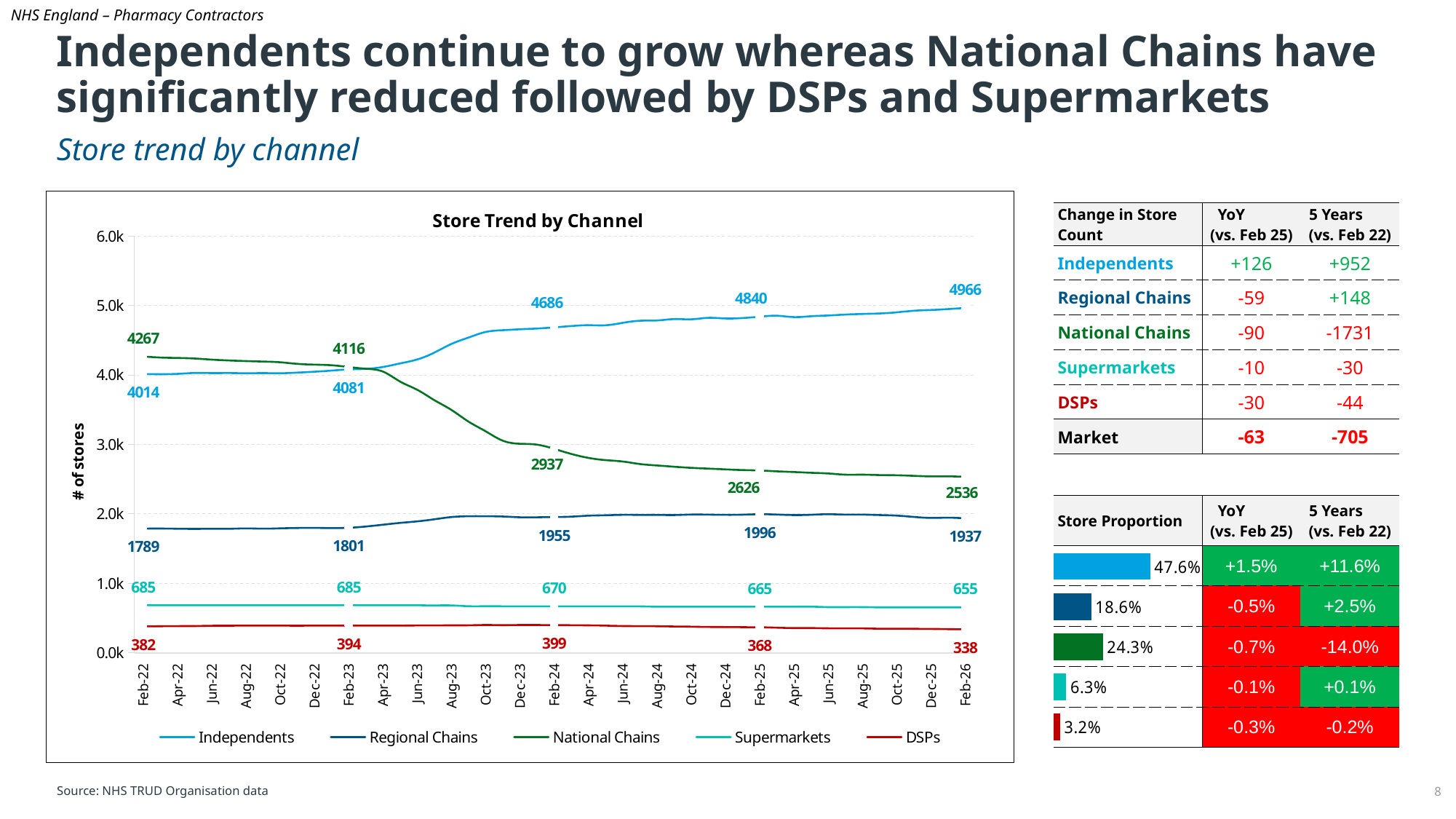
In the 'Store Trend by Channel' chart, what is the label of the y axis? # of stores In the 'Store Trend by Channel' chart, what is the value for Independents at Feb-26? 4966 In the 'Store Trend by Channel' chart, what is the value for DSPs at Feb-22? 382 How many series does the legend of the 'Store Trend by Channel' chart list? 5 In the 'Store Trend by Channel' chart, what is the value for National Chains at Feb-24? 2937 In the 'Store Trend by Channel' chart, which series has the highest value at Feb-26? Independents In the 'Store Trend by Channel' chart, what is the difference between the Independents value at Feb-26 and at Feb-22? 952 In the 'Store Trend by Channel' chart, what is the value for Supermarkets at Feb-25? 665 What type of chart is 'Store Trend by Channel'? Line chart In the 'Store Trend by Channel' chart, does the National Chains line rise or fall from Feb-22 to Feb-26? Fall In the 'Store Trend by Channel' chart, which series has the lowest value at Feb-22? DSPs In the 'Store Trend by Channel' chart, which is larger at Feb-22: Independents or National Chains? National Chains